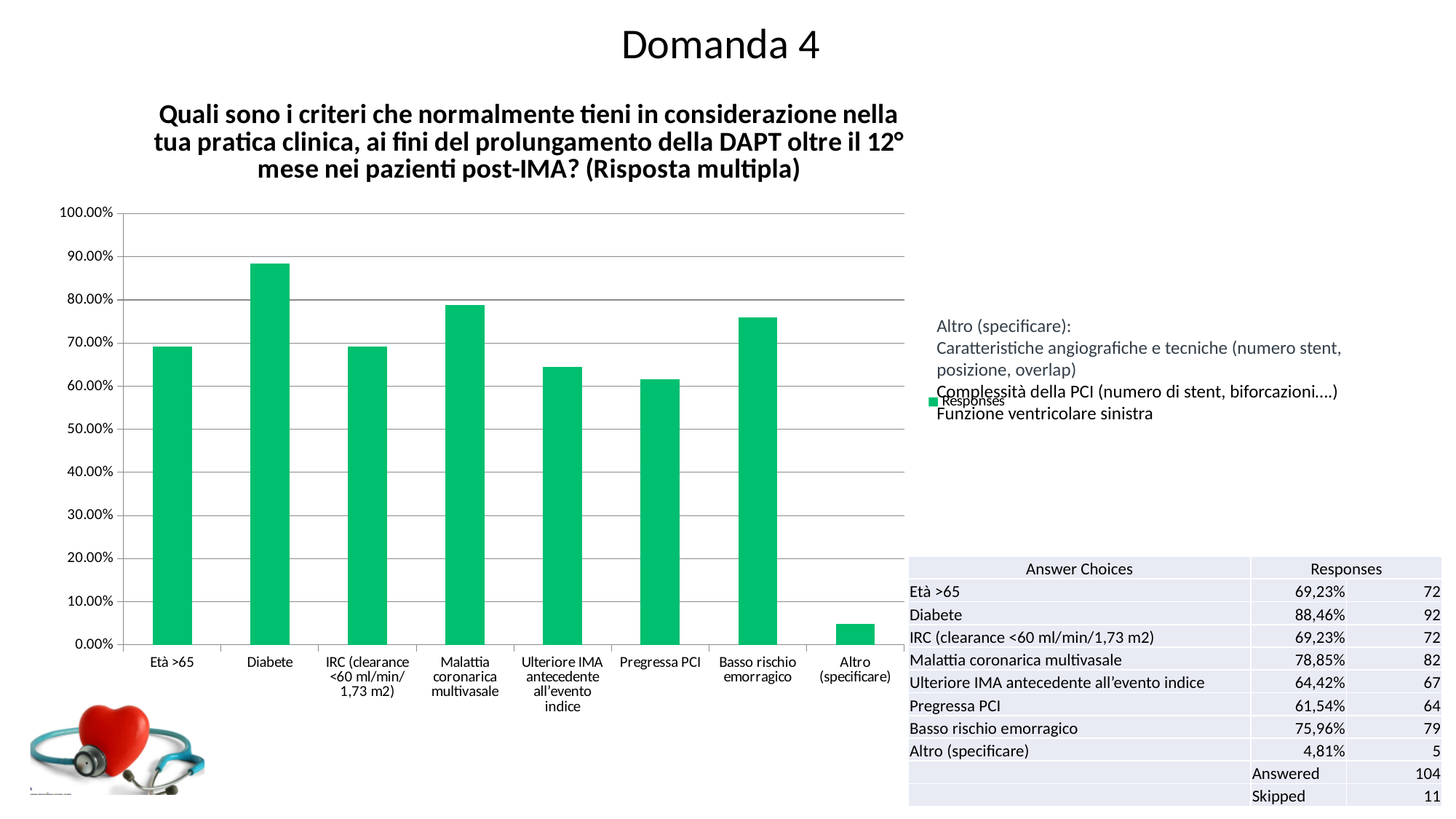
Is the value for Diabete greater or less than 80.00%? greater Which answer choice has the lowest response percentage? Altro (specificare) What kind of chart is shown on the slide? bar chart How many series does the chart legend list? 1 Which is larger, the value for Malattia coronarica multivasale or the value for Pregressa PCI? Malattia coronarica multivasale Which answer choice has the highest response percentage? Diabete Is the value for Altro (specificare) greater or less than 10.00%? less Is the value for Pregressa PCI greater or less than 60.00%? greater According to the table on the slide, what is the response percentage for Basso rischio emorragico? 75,96% According to the table on the slide, what is the response percentage for Ulteriore IMA antecedente all'evento indice? 64,42% What is the name of the series shown in the chart legend? Responses How many answer choices (categories) are plotted on the x axis of the chart? 8